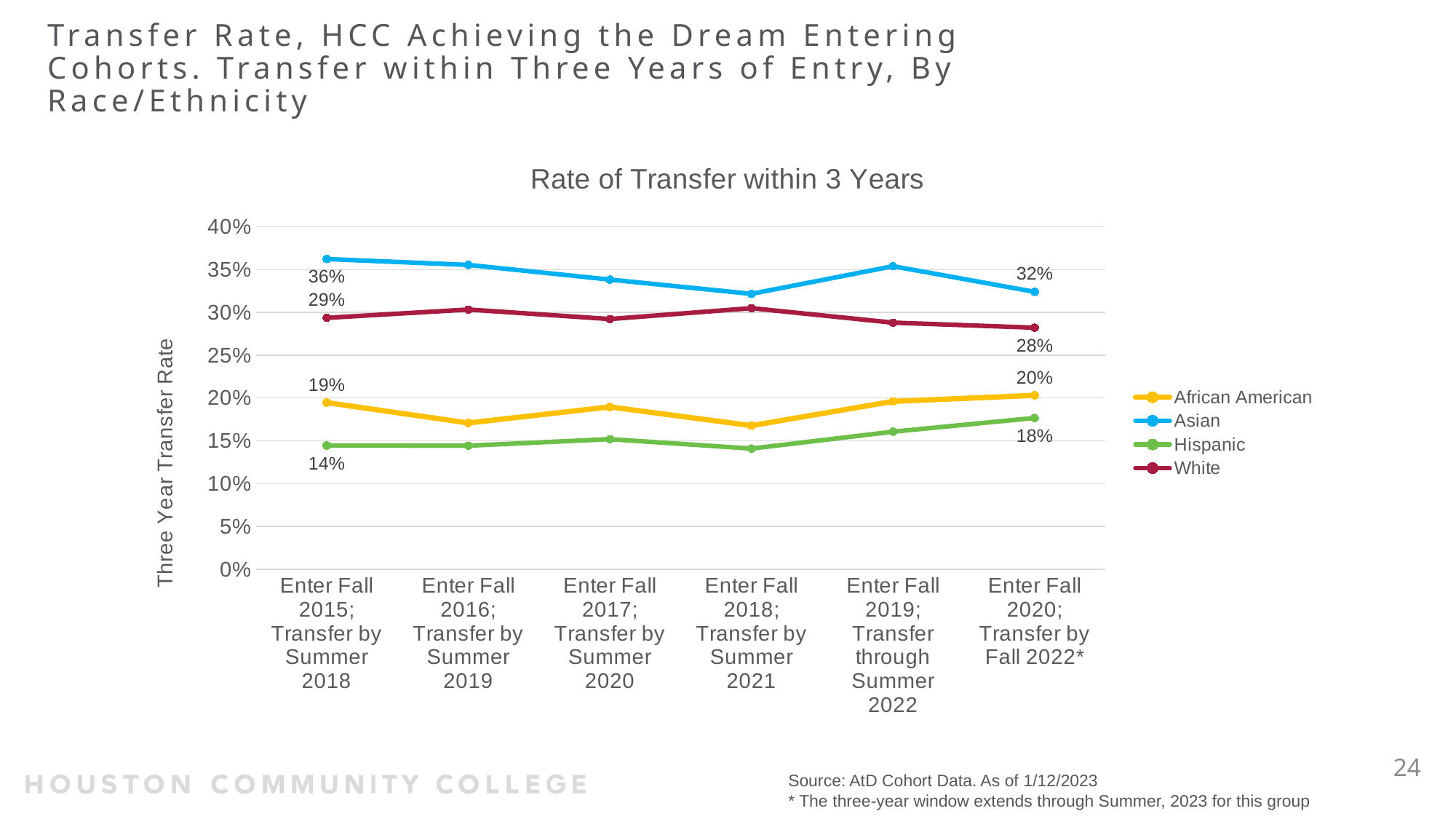
How many entering cohorts are plotted along the x axis? 6 What is the transfer rate for African American students in the Enter Fall 2020 cohort? 20% What type of chart is shown on the slide? line chart What is the difference between the Asian and Hispanic transfer rates for the Enter Fall 2015 cohort? 22 percentage points Which race/ethnicity group has the highest transfer rate in the Enter Fall 2020 cohort? Asian What is the transfer rate for Asian students in the Enter Fall 2015 cohort? 36% How many series does the legend list? 4 Which race/ethnicity group has the lowest transfer rate in the Enter Fall 2015 cohort? Hispanic What is the transfer rate for Hispanic students in the Enter Fall 2020 cohort? 18% Does the Hispanic transfer rate rise or fall from the Enter Fall 2015 cohort to the Enter Fall 2020 cohort? rise What is the transfer rate for White students in the Enter Fall 2015 cohort? 29% Is the Asian transfer rate for the Enter Fall 2018 cohort greater or less than 30%? greater